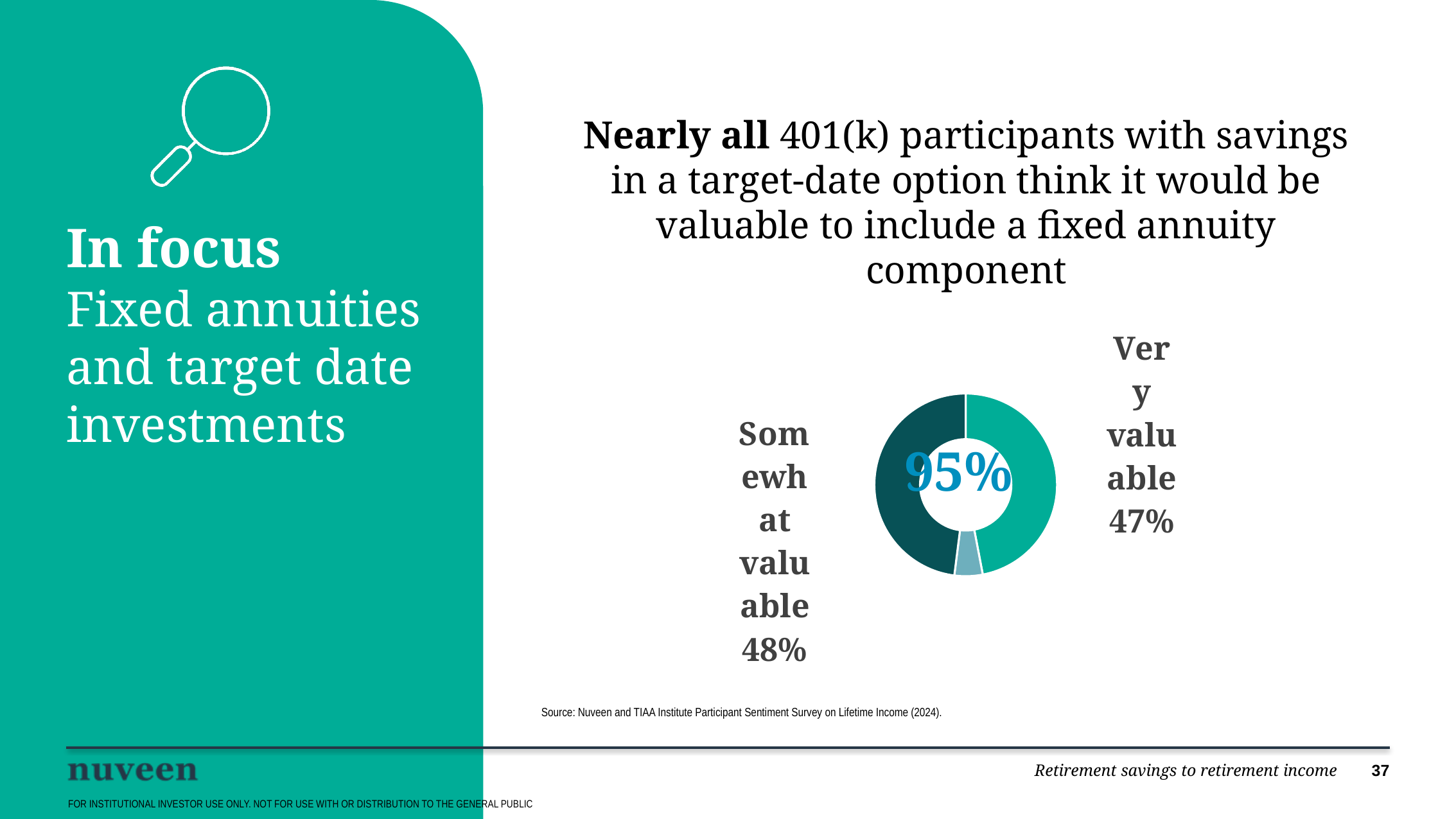
What percentage of participants said a fixed annuity component would be very valuable? 47% Is the share for 'Very valuable' greater or less than 50%? less What colour is the 'Somewhat valuable' slice of the donut chart? Dark teal What is the combined share of participants who said 'Very valuable' or 'Somewhat valuable'? 95% What kind of chart is shown on the slide? Pie (donut) chart Which labelled category has the smaller share of the donut chart? Very valuable How many slices does the donut chart have? 3 What value is printed in the centre of the donut chart? 95% Which labelled category has the largest share of the donut chart? Somewhat valuable What percentage of participants said a fixed annuity component would be somewhat valuable? 48% What is the difference between the 'Somewhat valuable' share and the 'Very valuable' share? 1% Which is larger, the share for 'Somewhat valuable' or the share for 'Very valuable'? Somewhat valuable